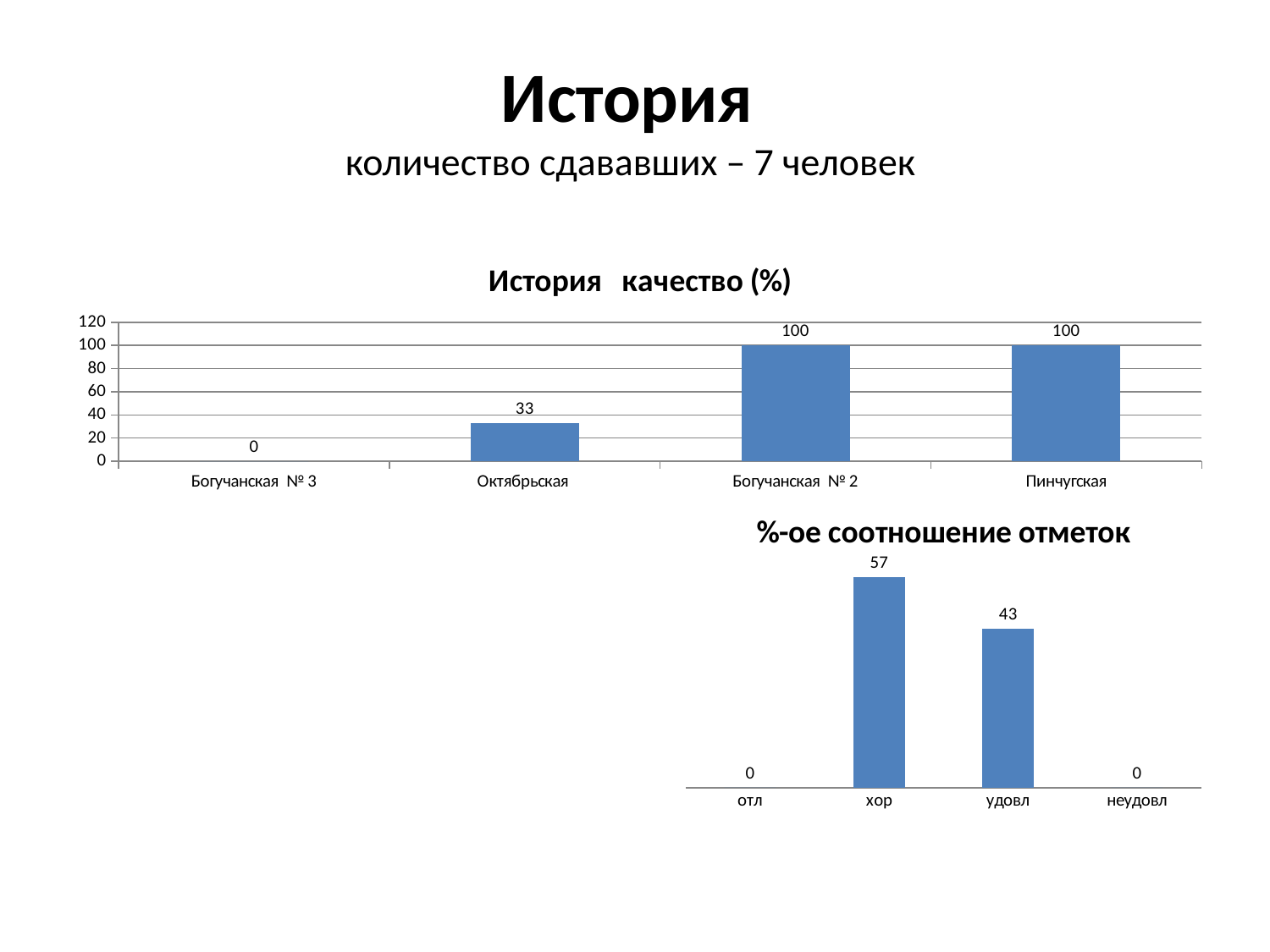
In the chart titled '%-ое соотношение отметок', what is the value for удовл? 43 In the chart titled 'История качество (%)', how many categories are shown on the x axis? 4 In the chart titled 'История качество (%)', is the value for Октябрьская greater or less than 40? less In the chart titled '%-ое соотношение отметок', what is the value for хор? 57 In the chart titled '%-ое соотношение отметок', what is the difference between the values for хор and удовл? 14 In the chart titled 'История качество (%)', which category has the lowest value? Богучанская № 3 In the chart titled '%-ое соотношение отметок', which is larger, the value for хор or the value for удовл? хор What kind of chart is the chart titled '%-ое соотношение отметок'? bar chart In the chart titled 'История качество (%)', what is the value for Богучанская № 3? 0 In the chart titled 'История качество (%)', what is the difference between the values for Пинчугская and Октябрьская? 67 In the chart titled '%-ое соотношение отметок', which category has the highest value? хор In the chart titled 'История качество (%)', what is the value for Октябрьская? 33